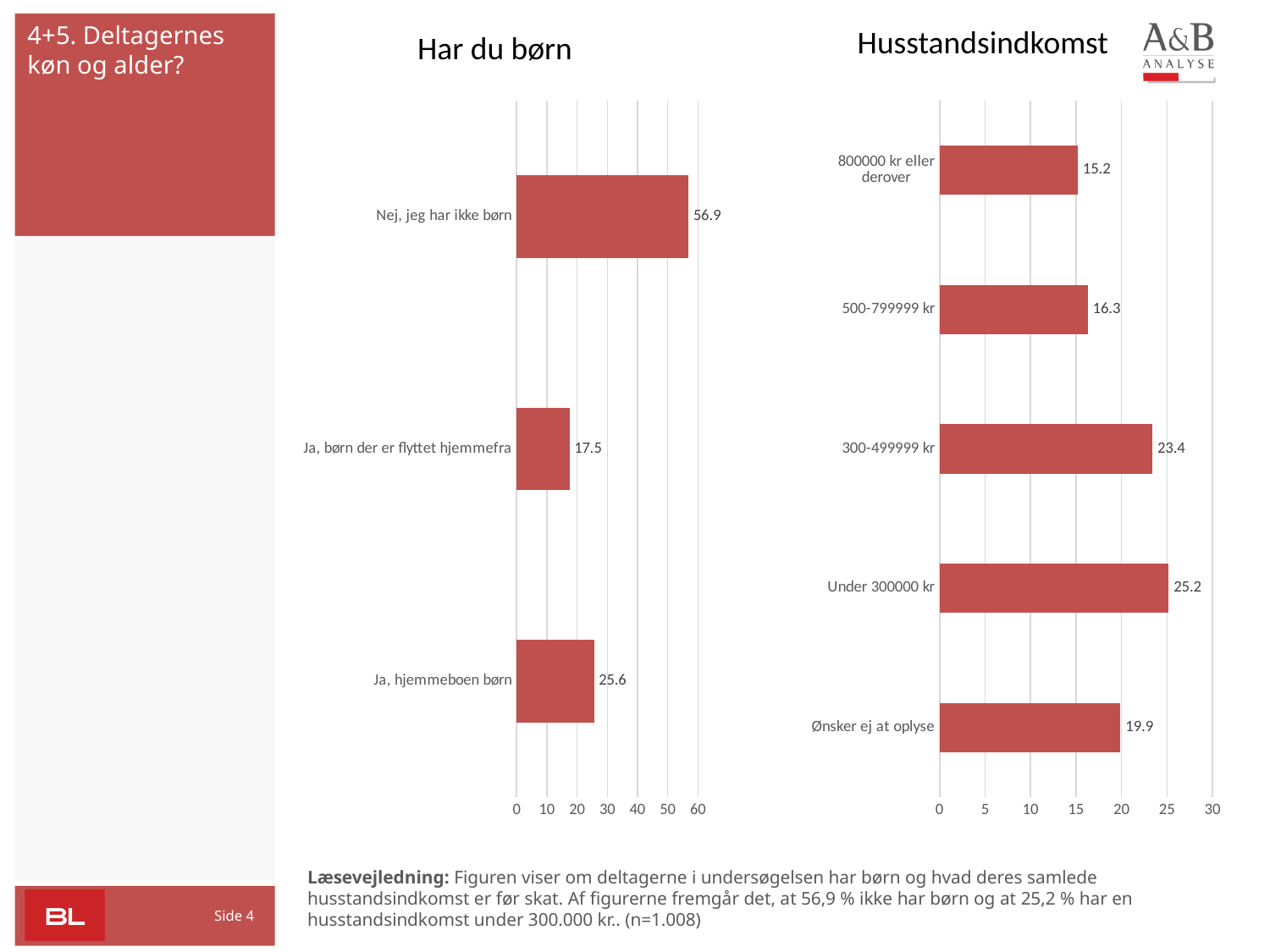
In the 'Har du børn' chart, what is the value for 'Nej, jeg har ikke børn'? 56.9 In the 'Husstandsindkomst' chart, what is the difference between 'Under 300000 kr' and '800000 kr eller derover'? 10 In the 'Har du børn' chart, how many categories are shown? 3 In the 'Har du børn' chart, what is the value for 'Ja, børn der er flyttet hjemmefra'? 17.5 In the 'Husstandsindkomst' chart, what is the value for 'Ønsker ej at oplyse'? 19.9 In the 'Har du børn' chart, what is the difference between 'Nej, jeg har ikke børn' and 'Ja, hjemmeboen børn'? 31.3 In the 'Husstandsindkomst' chart, which category has the highest value? Under 300000 kr In the 'Husstandsindkomst' chart, which is larger: '300-499999 kr' or '500-799999 kr'? 300-499999 kr In the 'Har du børn' chart, which category has the lowest value? Ja, børn der er flyttet hjemmefra In the 'Husstandsindkomst' chart, what is the value for '500-799999 kr'? 16.3 What type of chart is the 'Husstandsindkomst' chart? Bar chart In the 'Husstandsindkomst' chart, which category has the lowest value? 800000 kr eller derover